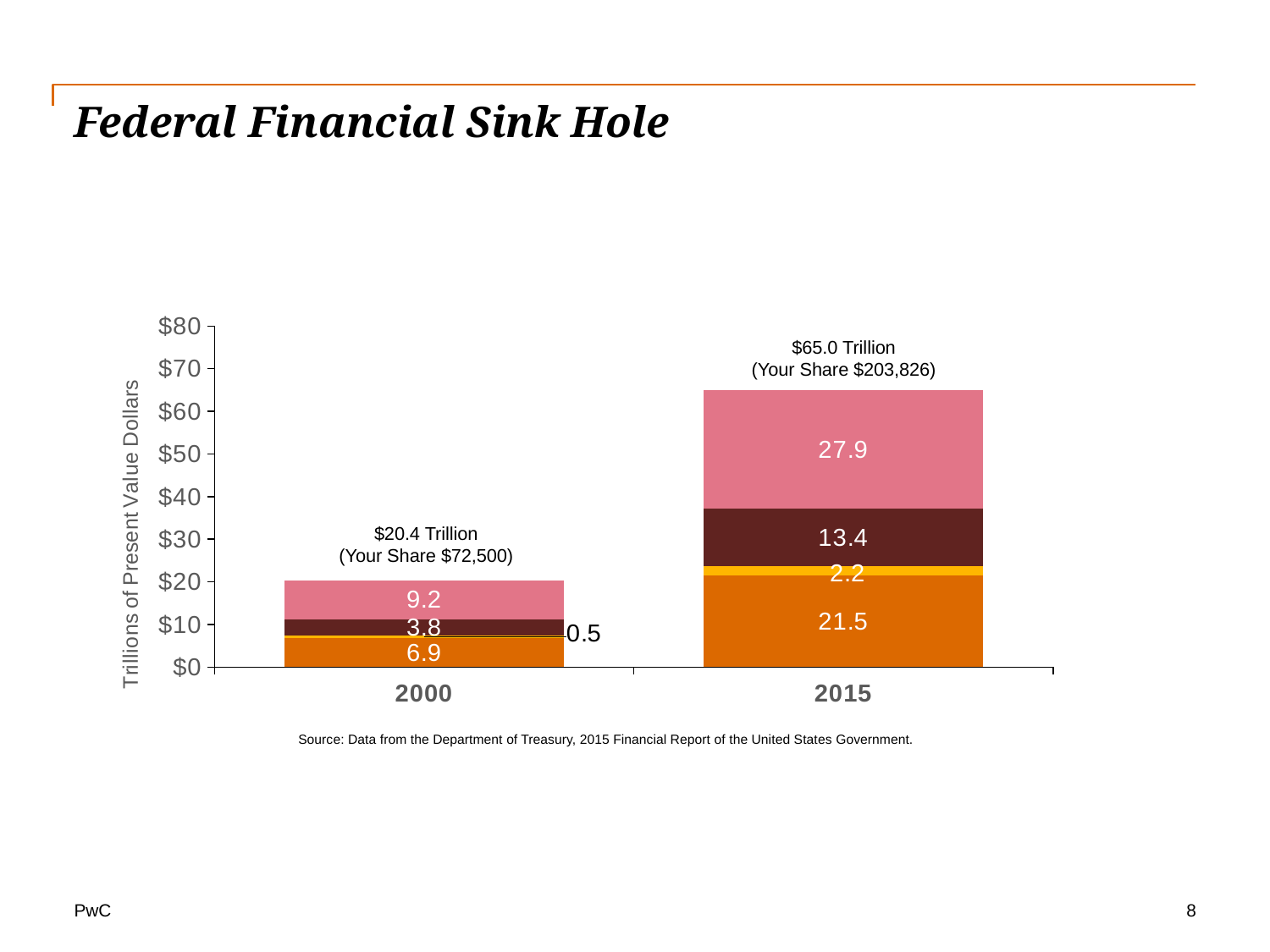
What is the total value of the stacked bar for 2000? $20.4 Trillion Is the total for the 2015 bar greater or less than $60? greater What kind of chart is shown on the slide? stacked bar chart What is the total value of the stacked bar for 2015? $65.0 Trillion What is the value of the dark brown segment in the 2015 bar? 13.4 What is the value of the orange (bottom) segment in the 2000 bar? 6.9 Which year has the taller stacked bar, 2000 or 2015? 2015 What is the value of the pink (top) segment in the 2015 bar? 27.9 What is the value of the thin yellow segment in the 2000 bar? 0.5 How many categories (years) are shown on the x axis? 2 What is the difference between the orange segment values for 2015 and 2000? 14.6 What is the 'Your Share' amount shown above the 2015 bar? $203,826